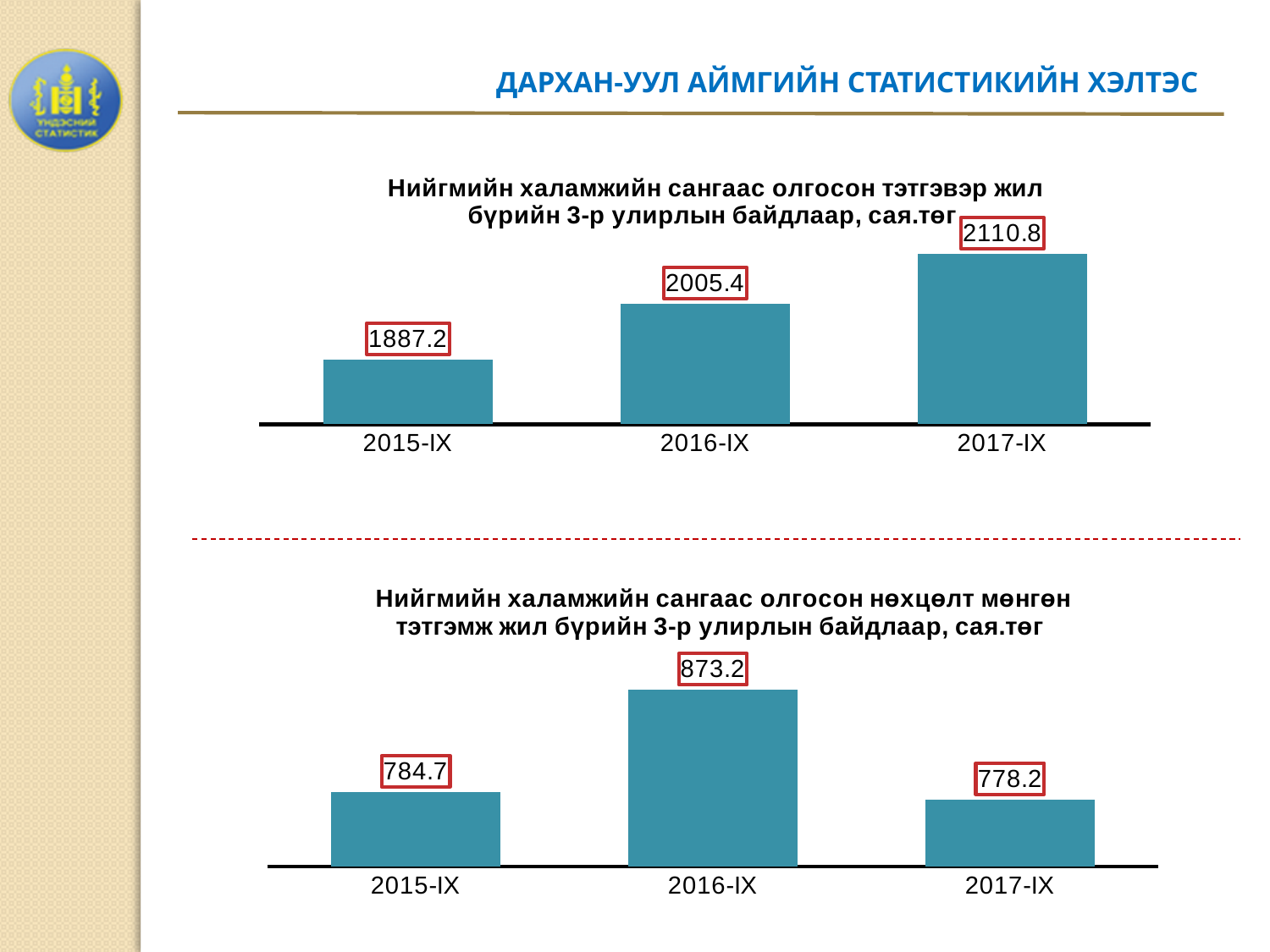
What type of chart is the bottom chart? bar chart In the bottom chart (conditional cash benefit from the social welfare fund), what is the value for 2016-IX? 873.2 In the bottom chart (conditional cash benefit from the social welfare fund), what is the difference between the 2016-IX and 2015-IX values? 88.5 In the top chart (pension from the social welfare fund), do the values rise or fall from 2015-IX to 2017-IX? rise In the bottom chart (conditional cash benefit from the social welfare fund), which period has the highest value? 2016-IX In the bottom chart (conditional cash benefit from the social welfare fund), which period has the lowest value? 2017-IX How many periods are shown on the x axis of the top chart? 3 In the top chart (pension from the social welfare fund), what is the value for 2015-IX? 1887.2 In the top chart (pension from the social welfare fund), what is the value for 2017-IX? 2110.8 In the bottom chart (conditional cash benefit from the social welfare fund), what is the value for 2017-IX? 778.2 In the top chart (pension from the social welfare fund), what is the difference between the 2017-IX and 2015-IX values? 223.6 In the top chart (pension from the social welfare fund), which period has the highest value? 2017-IX